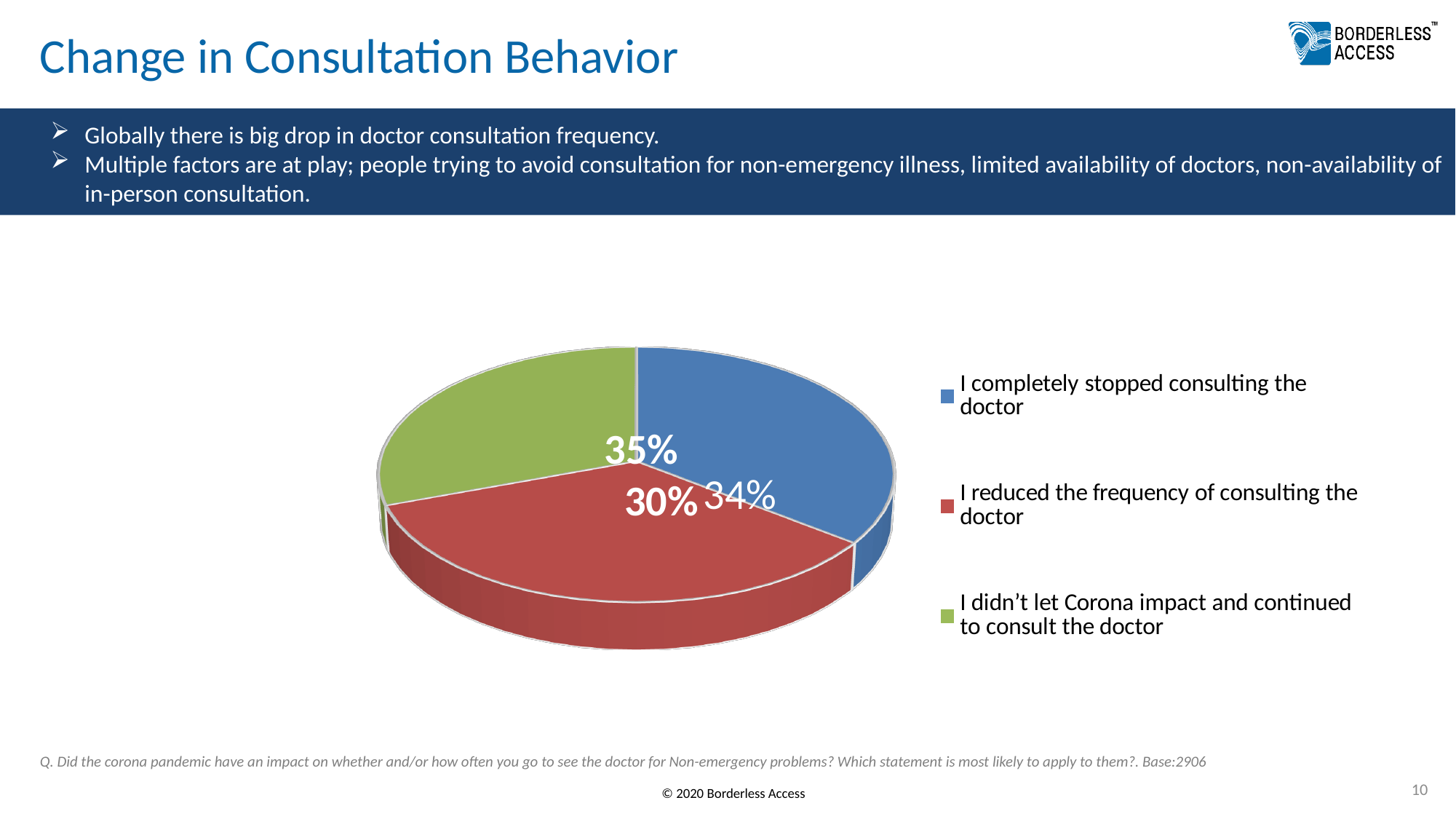
Which response has the smallest share of the pie? I didn't let Corona impact and continued to consult the doctor What percentage of respondents said 'I completely stopped consulting the doctor'? 35% What kind of chart is shown on the slide? pie chart How many slices does the pie chart have? 3 What is the difference in percentage points between 'I reduced the frequency of consulting the doctor' and 'I didn't let Corona impact and continued to consult the doctor'? 4 What colour is the slice for 'I didn't let Corona impact and continued to consult the doctor'? green What percentage of respondents said 'I reduced the frequency of consulting the doctor'? 34% How many entries does the legend of the pie chart list? 3 Which is larger: the share for 'I reduced the frequency of consulting the doctor' or the share for 'I didn't let Corona impact and continued to consult the doctor'? I reduced the frequency of consulting the doctor What colour is the slice for 'I completely stopped consulting the doctor'? blue What percentage of respondents said 'I didn't let Corona impact and continued to consult the doctor'? 30%